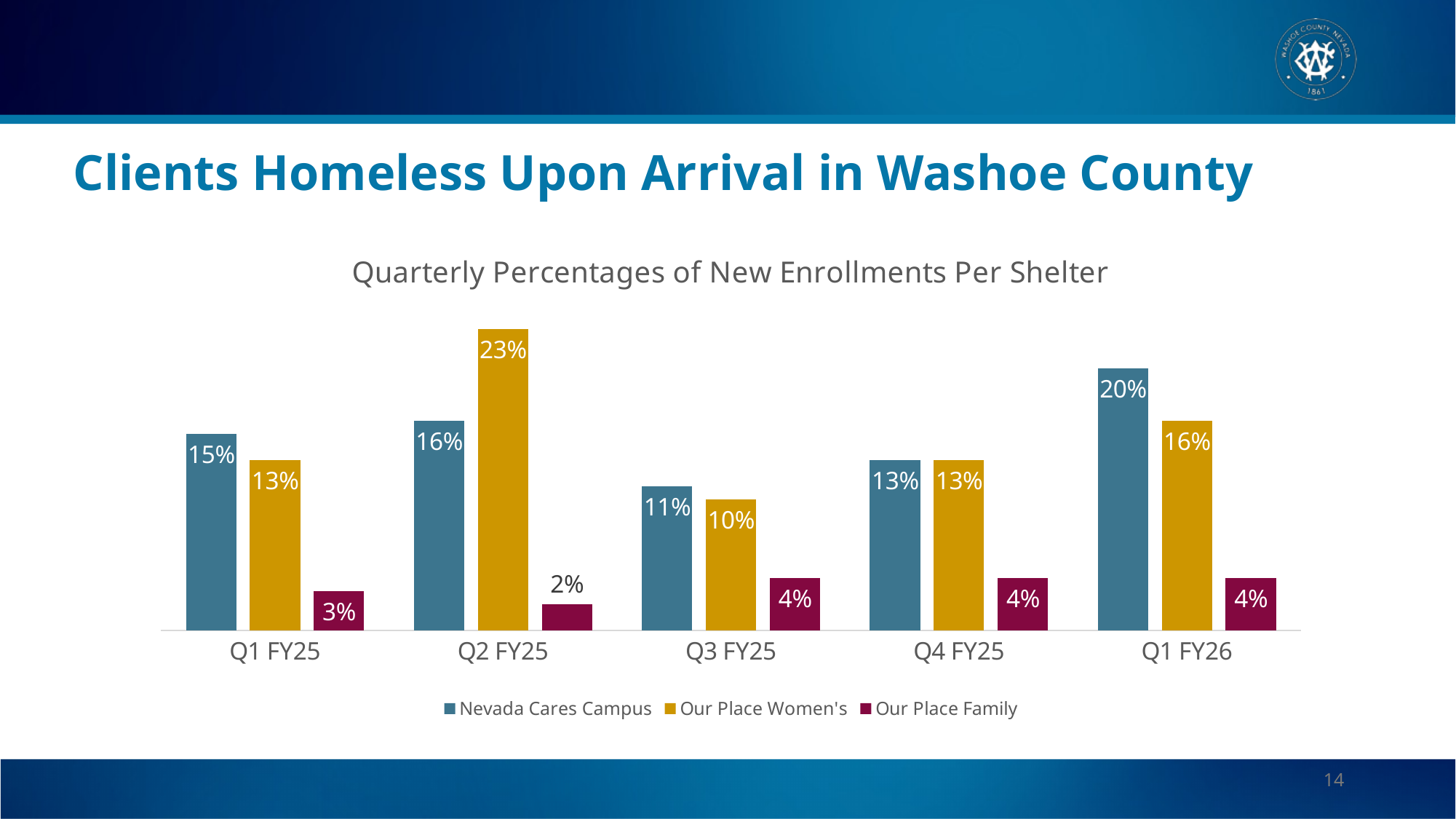
How many quarters are shown on the x axis? 5 In which quarter is the Our Place Women's value highest? Q2 FY25 In which quarter is the Nevada Cares Campus value lowest? Q3 FY25 What is the value for Nevada Cares Campus in Q1 FY26? 20% What is the value for Our Place Family in Q2 FY25? 2% How many series does the legend list? 3 What kind of chart is shown on the slide? Bar chart What is the value for Our Place Women's in Q2 FY25? 23% What is the difference between Nevada Cares Campus and Our Place Women's in Q1 FY26? 4% Does the Nevada Cares Campus value rise or fall from Q3 FY25 to Q1 FY26? Rise What is the title of the chart? Quarterly Percentages of New Enrollments Per Shelter Which is larger in Q2 FY25: Nevada Cares Campus or Our Place Women's? Our Place Women's